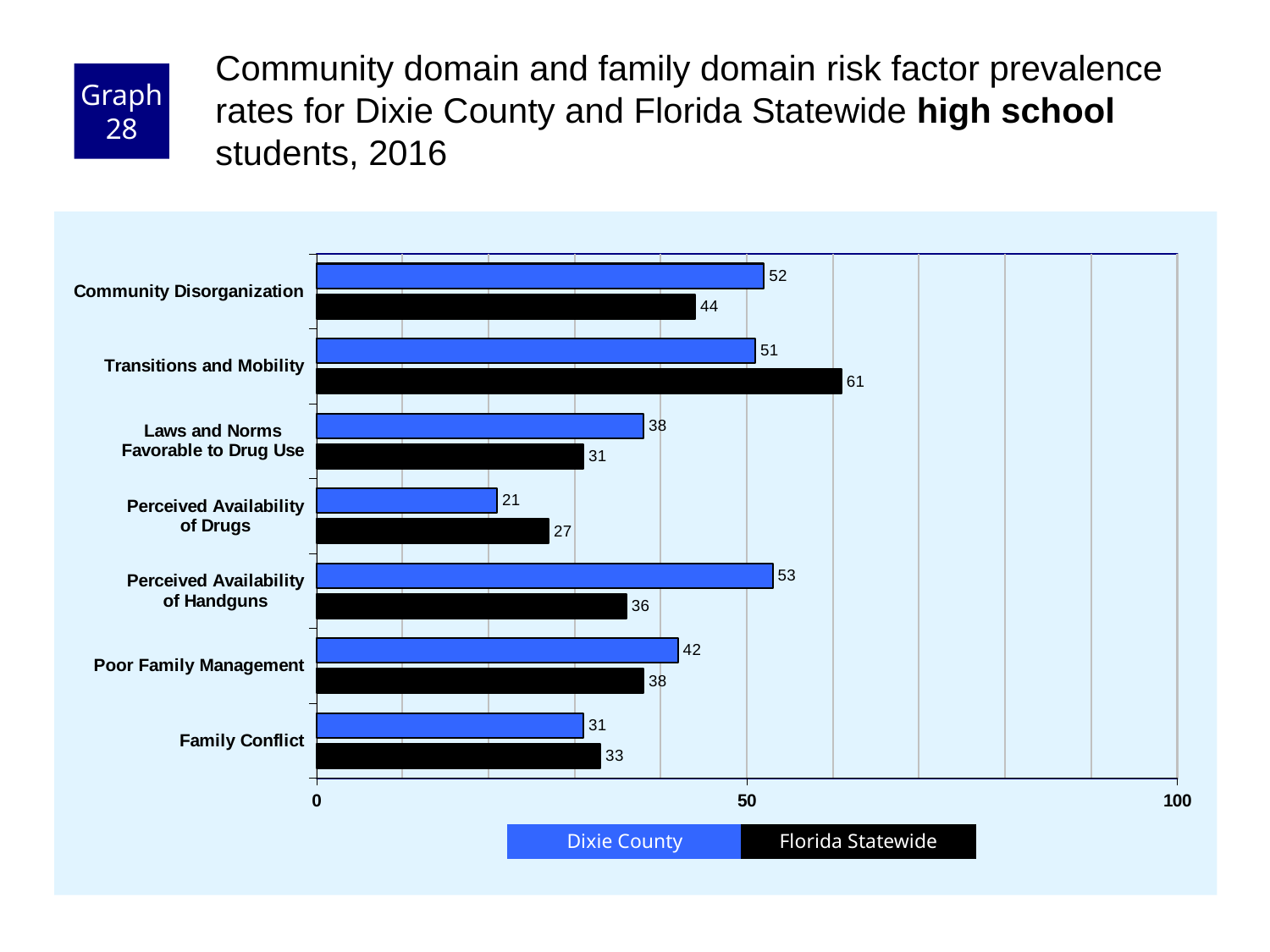
What kind of chart is shown on the slide? bar chart Which colour represents Florida Statewide in the chart? black What is the Dixie County value for Perceived Availability of Drugs? 21 How many series does the legend list? 2 What is the difference between the Dixie County and Florida Statewide values for Perceived Availability of Handguns? 17 Which risk factor has the highest Dixie County value? Perceived Availability of Handguns Which risk factor has the lowest Florida Statewide value? Perceived Availability of Drugs Which is larger for Family Conflict, the Dixie County value or the Florida Statewide value? Florida Statewide What is the Dixie County value for Community Disorganization? 52 What is the Florida Statewide value for Transitions and Mobility? 61 Is the Florida Statewide value for Transitions and Mobility greater or less than 50? greater How many risk factors are shown on the chart? 7